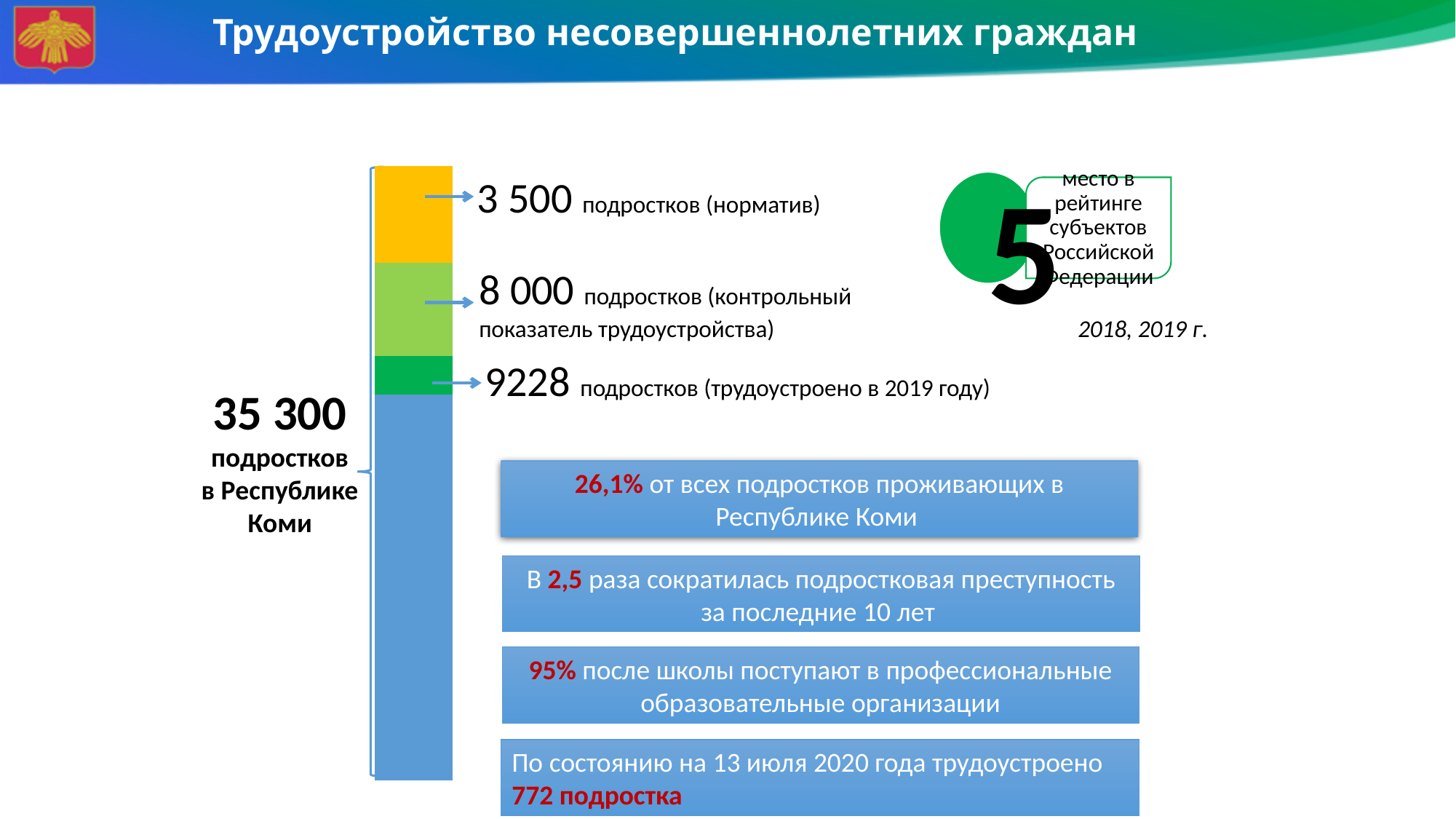
Which is larger: the норматив or the number трудоустроено в 2019 году? трудоустроено в 2019 году How many подростков were трудоустроено в 2019 году according to the chart? 9228 What value is shown for подростков (норматив)? 3 500 What is the difference between the контрольный показатель (8 000) and the норматив (3 500)? 4 500 What kind of chart is used on the slide? bar chart What colour is the segment labelled 9228 подростков (трудоустроено в 2019 году)? dark green How many coloured segments make up the bar? 4 Which of the three labelled segments has the smallest value? норматив (3 500) What is the total number of подростков в Республике Коми shown for the whole bar? 35 300 What colour is the segment labelled 3 500 подростков (норматив)? yellow What is the difference between the number трудоустроено в 2019 году (9228) and the контрольный показатель (8 000)? 1228 What value is shown for подростков (контрольный показатель трудоустройства)? 8 000